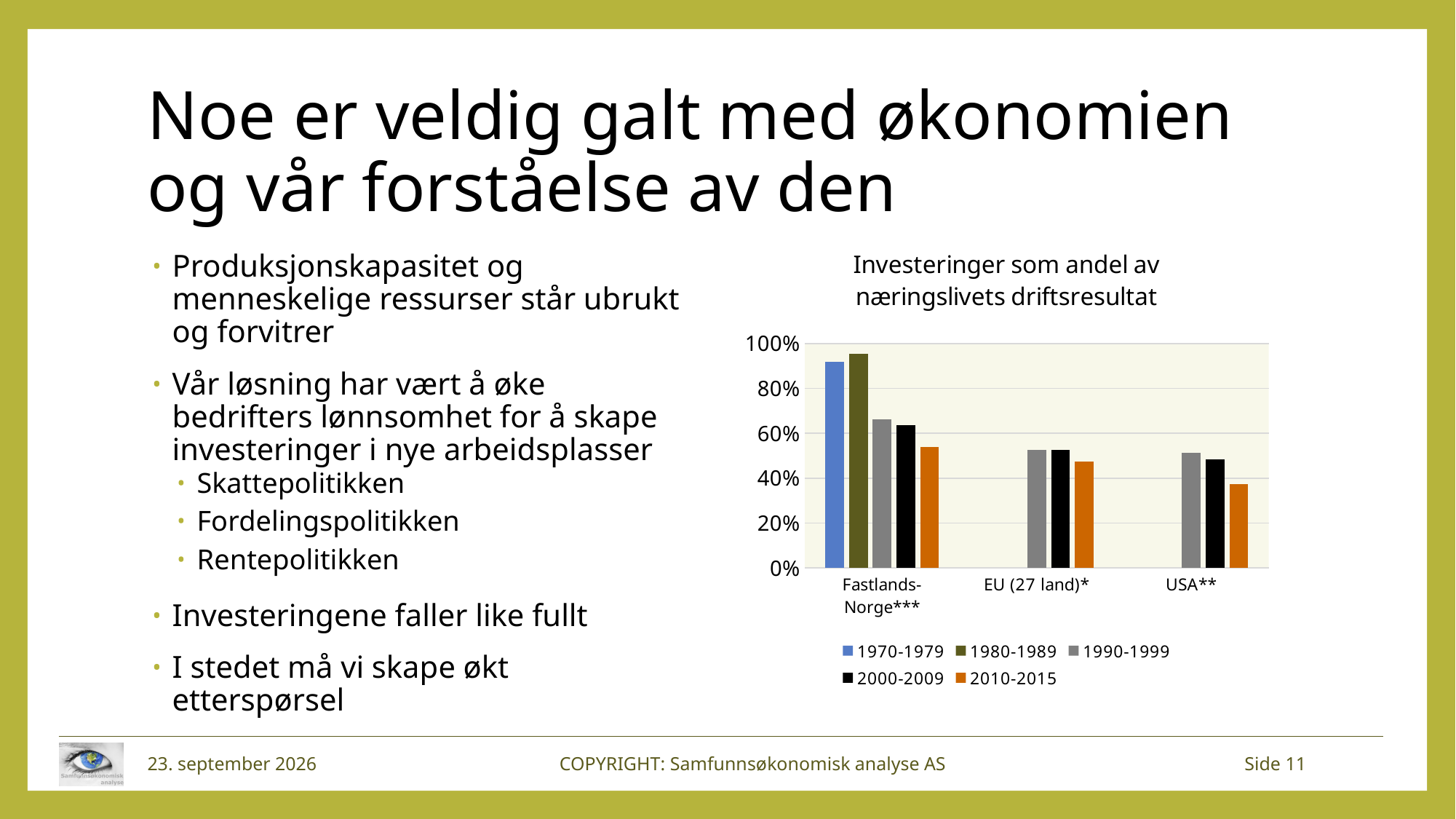
Is the value for Fastlands-Norge*** in 1980-1989 greater or less than 80%? greater Is the value for EU (27 land)* in 2000-2009 greater or less than 60%? less How many categories are shown on the x axis of the chart? 3 Which period has the lowest value for USA**? 2010-2015 What is the title of the chart? Investeringer som andel av næringslivets driftsresultat What kind of chart is shown on the slide? bar chart How many series does the chart's legend list? 5 Which is larger: the 2010-2015 value for Fastlands-Norge*** or the 2010-2015 value for USA**? Fastlands-Norge*** Which period has the highest value for Fastlands-Norge***? 1980-1989 Do the values for Fastlands-Norge*** rise or fall from 1980-1989 to 2010-2015? fall Is the value for USA** in 2010-2015 greater or less than 40%? less Which category has bars for all five periods in the legend? Fastlands-Norge***